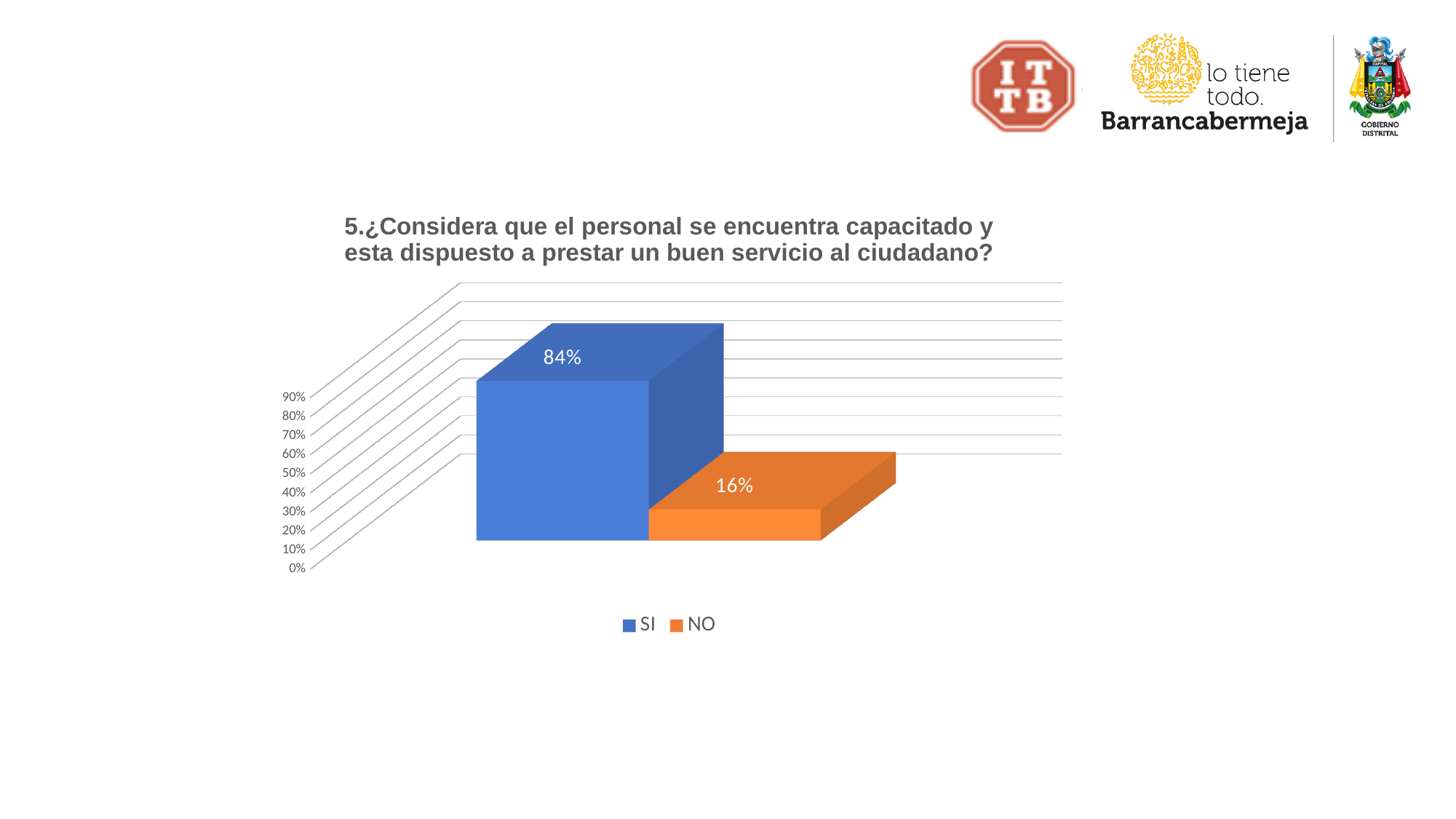
Is the value for NO greater or less than 30%? less What is the value for NO? 16% What is the difference between the values for SI and NO? 68% What is the value for SI? 84% Which is larger, the value for SI or the value for NO? SI Which category has the highest value? SI Is the value for SI greater or less than 50%? greater What is the highest value shown on the vertical axis? 90% What kind of chart is shown on the slide? Bar chart How many series does the legend list? 2 What colour is the bar for NO? Orange Which category has the lowest value? NO